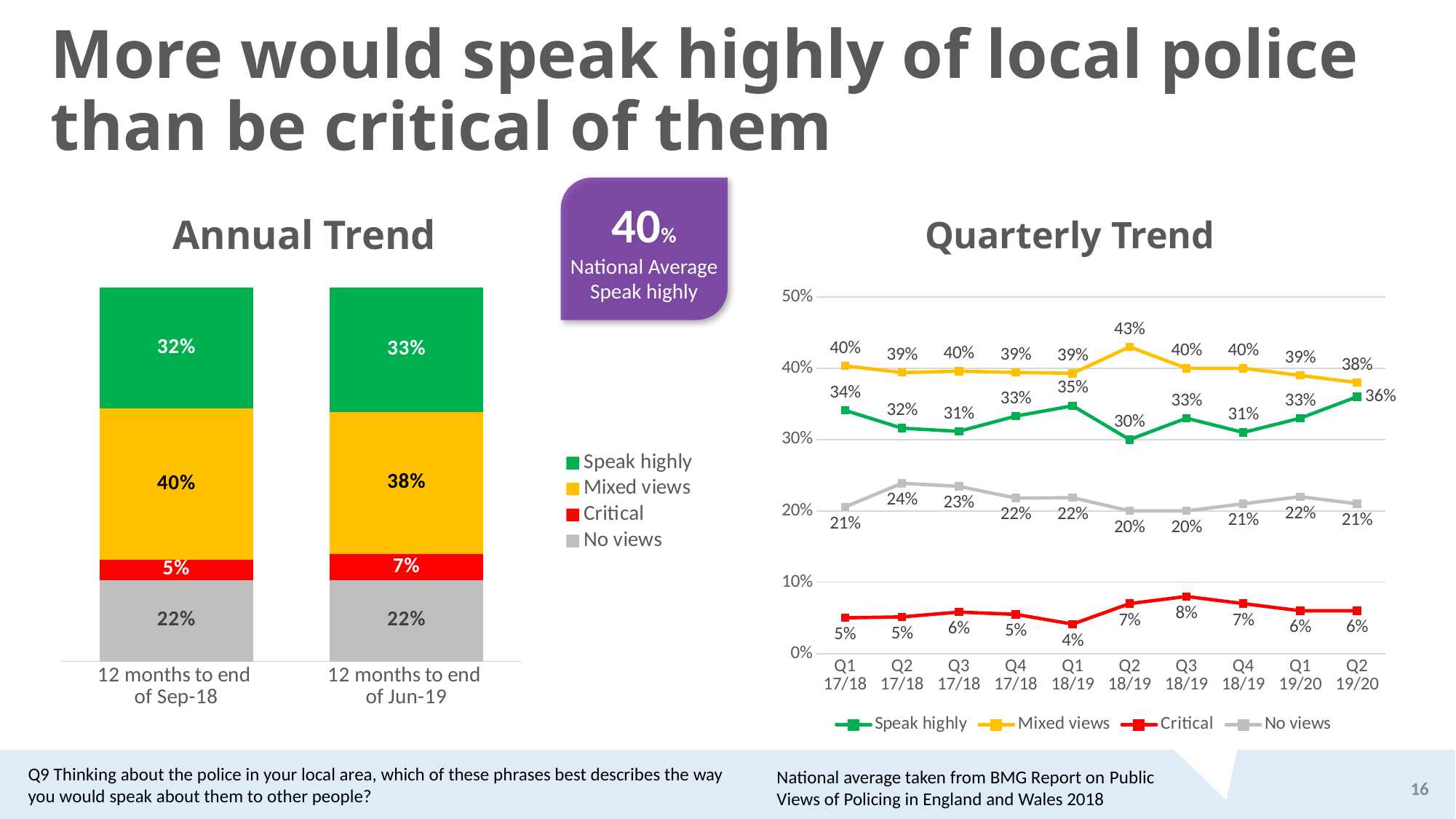
In the Quarterly Trend chart, what is the Mixed views value for Q2 18/19? 43% In the Quarterly Trend chart, is the Speak highly value for Q3 18/19 larger or smaller than the Mixed views value for the same quarter? Smaller What type of chart is the Annual Trend chart? Stacked bar chart In the Quarterly Trend chart, how many quarters are plotted on the x axis? 10 How many series does the legend of the Quarterly Trend chart list? 4 What is the National Average for Speak highly shown on the slide? 40% In the Annual Trend chart, what is the Critical value for the 12 months to end of Sep-18? 5% In the Quarterly Trend chart, which quarter has the lowest Critical value? Q1 18/19 In the Annual Trend chart, what percentage of respondents would speak highly of local police in the 12 months to end of Jun-19? 33% In the Annual Trend chart, what is the total of the stacked bar for the 12 months to end of Jun-19? 100% In the Annual Trend chart, what is the difference in the Mixed views value between the 12 months to end of Sep-18 and the 12 months to end of Jun-19? 2% In the Quarterly Trend chart, which quarter has the highest Speak highly value? Q2 19/20